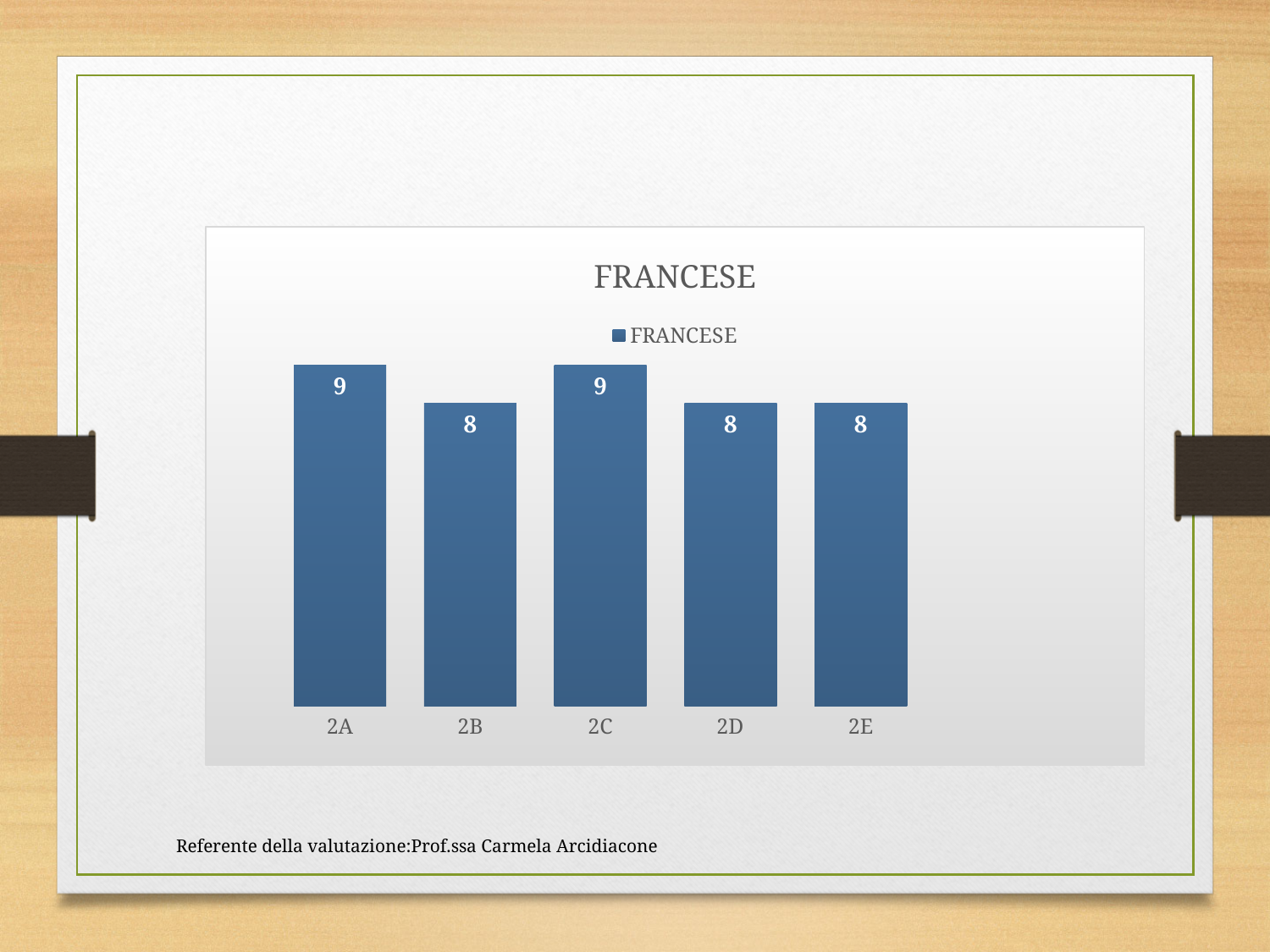
What is the value for 2D? 8 What kind of chart is shown? bar chart How many series does the legend list? 1 What is the name of the series in the legend? FRANCESE What is the value for 2E? 8 What is the value for 2A? 9 What is the difference between the values for 2A and 2B? 1 What is the value for 2C? 9 What is the title of the chart? FRANCESE How many categories are shown on the x axis? 5 Which is larger, the value for 2C or the value for 2D? 2C What is the value for 2B? 8